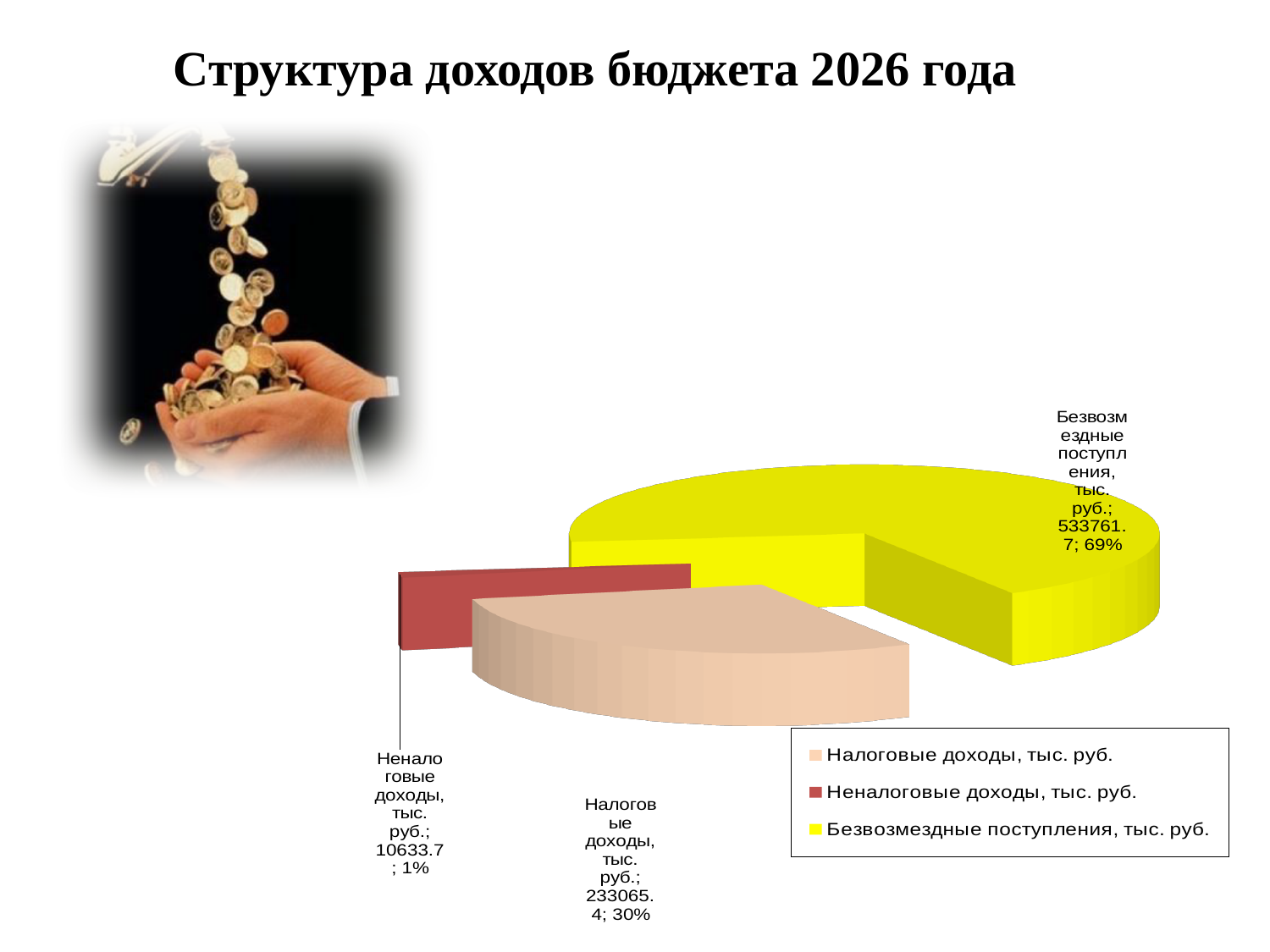
What is the difference between the values for Безвозмездные поступления and Налоговые доходы? 300696.3 How many categories does the pie chart have? 3 Which is larger: Налоговые доходы or Неналоговые доходы? Налоговые доходы Which category has the largest slice of the pie? Безвозмездные поступления, тыс. руб. What type of chart is shown on the slide? Pie chart What share of the pie does Налоговые доходы represent? 30% What is the value for Безвозмездные поступления, тыс. руб.? 533761.7 What is the value for Неналоговые доходы, тыс. руб.? 10633.7 What is the value for Налоговые доходы, тыс. руб.? 233065.4 What is the title of the slide? Структура доходов бюджета 2026 года Which category has the smallest slice of the pie? Неналоговые доходы, тыс. руб. What share of the pie does Безвозмездные поступления represent? 69%